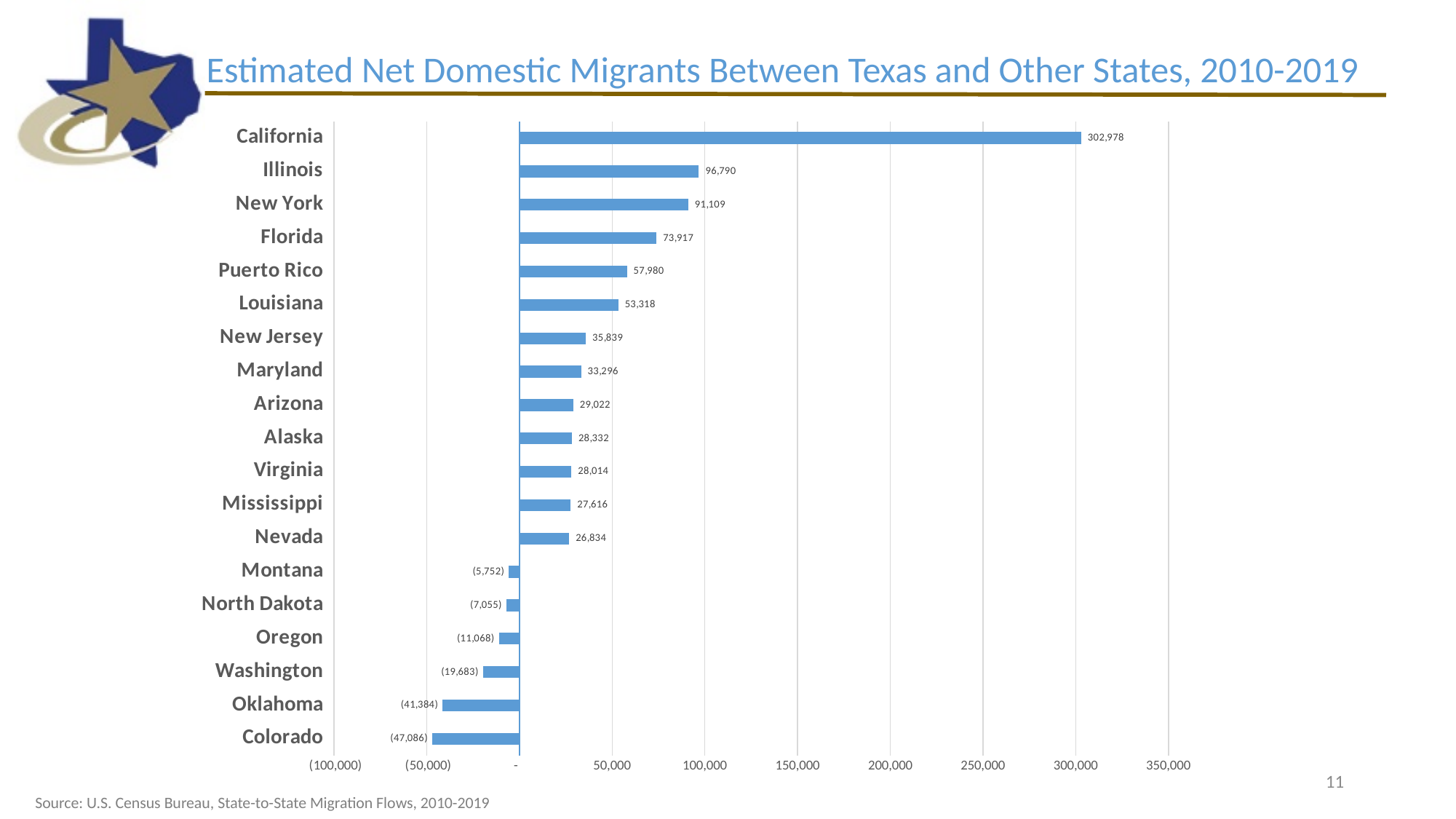
What is the value for Puerto Rico? 57,980 What kind of chart is shown on the slide? bar chart What is the value for Colorado? (47,086) Is the value for Louisiana greater or less than 50,000? greater How many states or territories are shown on the chart? 19 What is the difference between the values for California and Illinois? 206,188 What is the value for California? 302,978 What is the difference between the values for Florida and Puerto Rico? 15,937 Which is larger, the value for Illinois or the value for New York? Illinois Which state has the lowest value? Colorado Which state has the highest value? California What is the title of the chart? Estimated Net Domestic Migrants Between Texas and Other States, 2010-2019